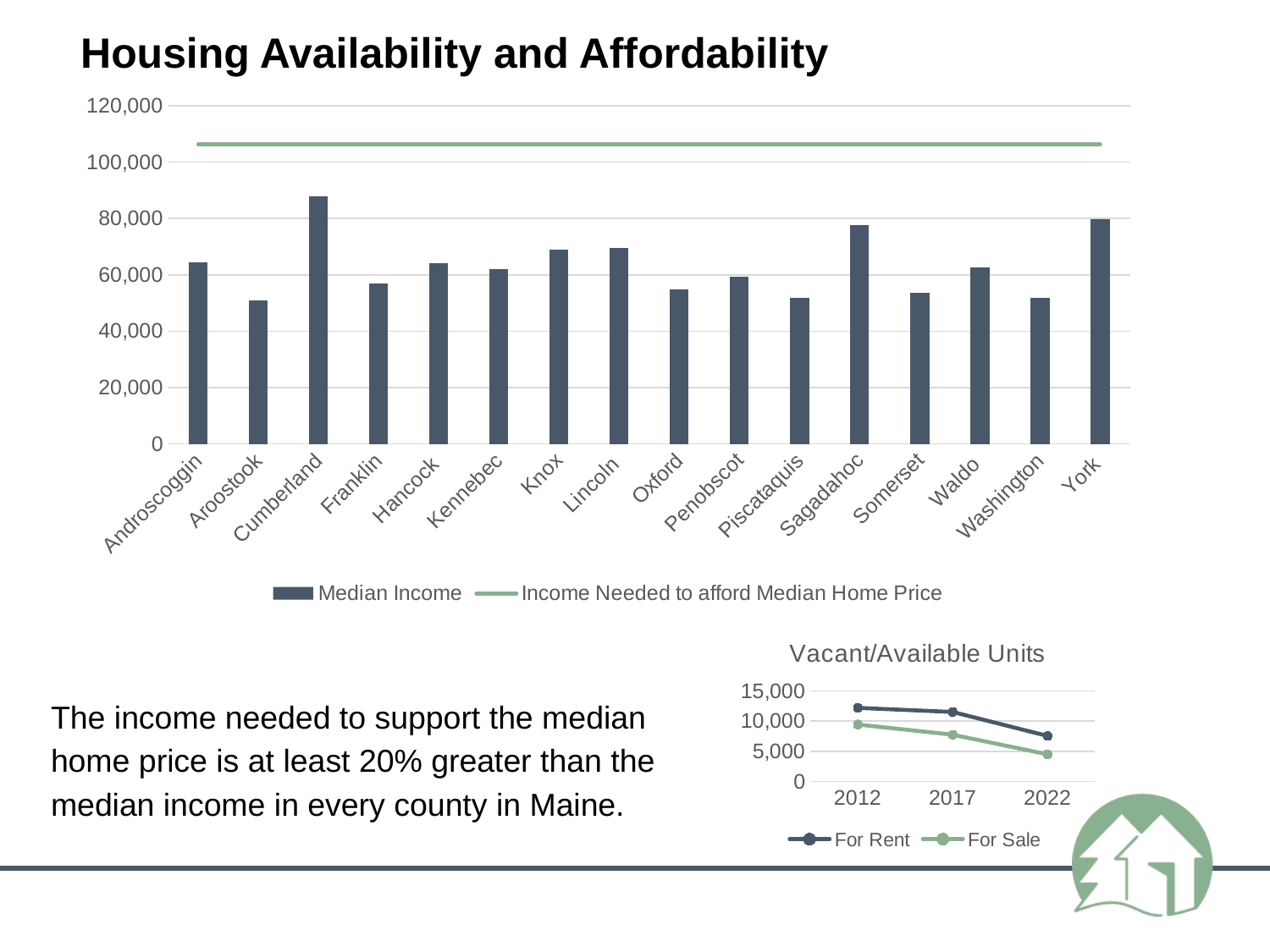
On the top chart, is the Median Income for Knox greater or less than 60,000? greater On the Vacant/Available Units chart, which series is higher in 2012, For Rent or For Sale? For Rent How many counties are shown on the top chart? 16 On the top chart, is the Median Income for Aroostook greater or less than 60,000? less On the top chart, which has the larger Median Income, Cumberland or Oxford? Cumberland On the top chart, is the Median Income for Cumberland greater or less than 80,000? greater What kind of chart is the Vacant/Available Units chart? line chart On the top chart, which county has the highest Median Income? Cumberland On the Vacant/Available Units chart, do the For Rent values rise or fall from 2012 to 2022? fall How many series does the legend of the top chart list? 2